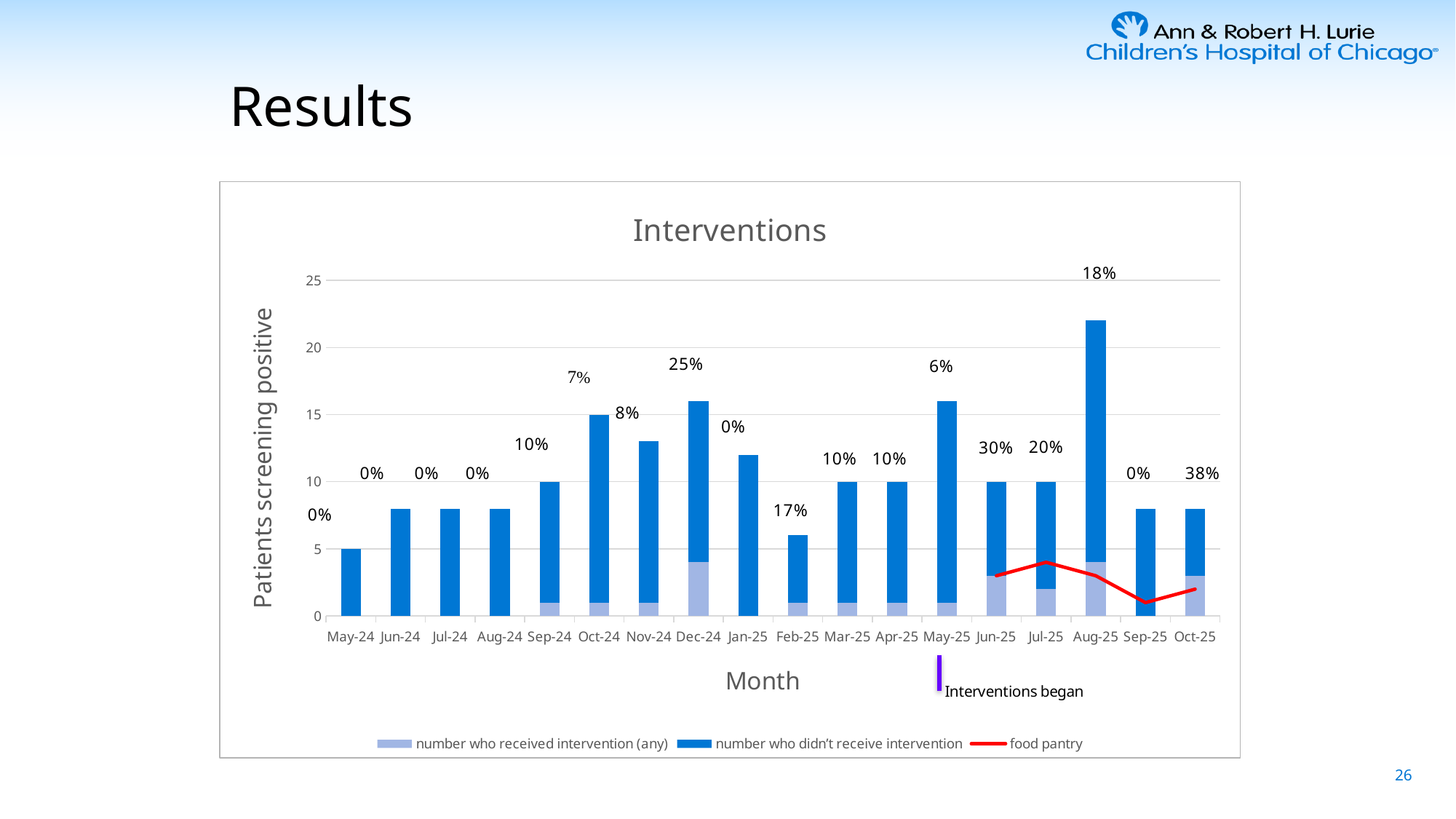
What kind of chart is shown on the slide? Bar chart (stacked bars with a line) How many months are shown on the x axis? 18 What percentage label is shown above the Oct-25 bar? 38% Which month has the tallest bar for patients screening positive? Aug-25 Is the total bar height for Aug-25 greater or less than 20? greater Which month has the highest percentage label? Oct-25 What is the title of the chart? Interventions Is the total bar height for Feb-25 greater or less than 10? less How many series does the legend list? 3 What is the difference between the percentage labels for Oct-25 and Jun-25? 8 percentage points What percentage label is shown above the Dec-24 bar? 25% Which series is drawn as a red line in the chart? food pantry